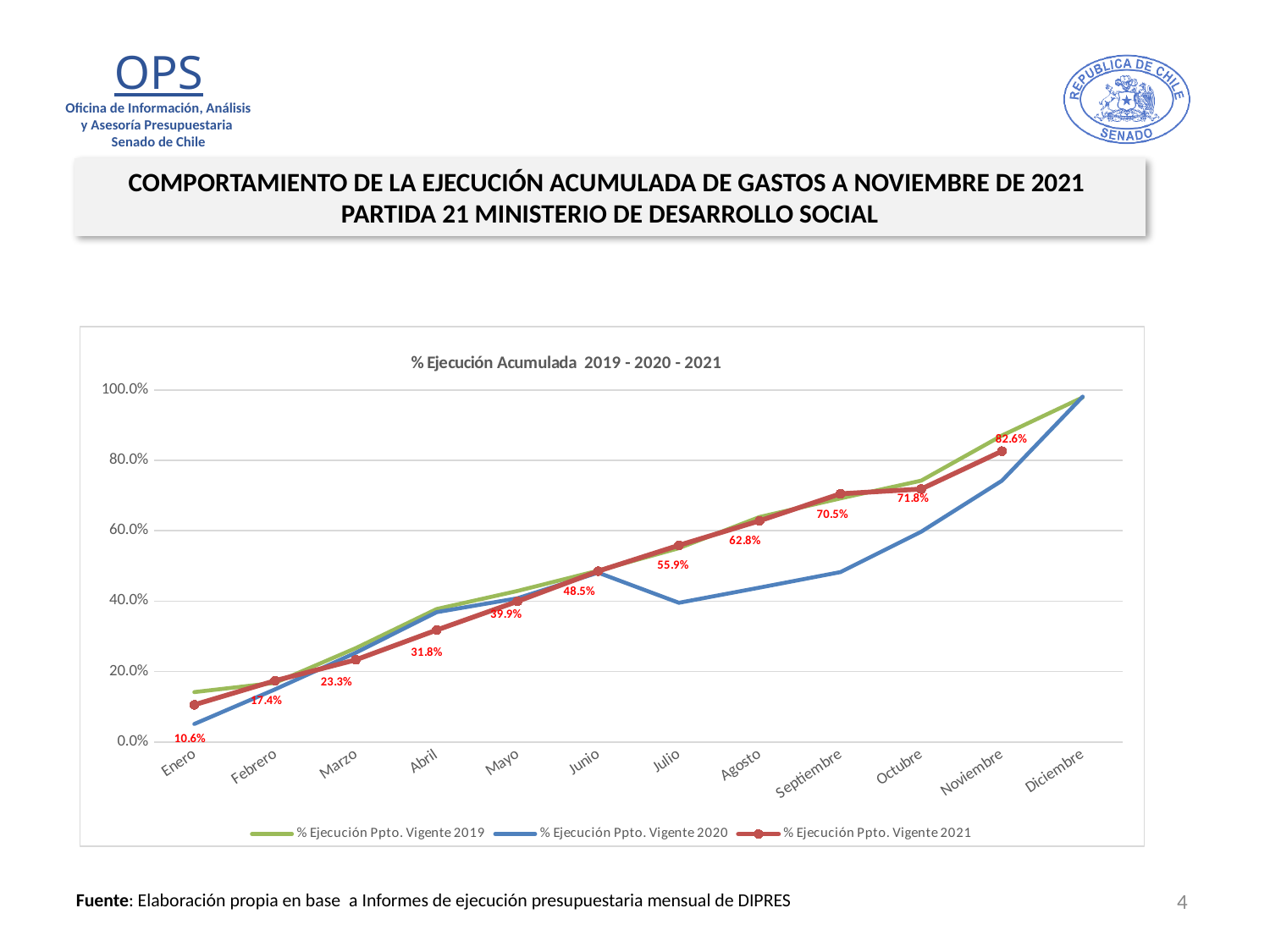
By how many percentage points did % Ejecución Ppto. Vigente 2021 increase from Octubre to Noviembre? 10.8% What is the title of the chart? % Ejecución Acumulada 2019 - 2020 - 2021 Is the value for % Ejecución Ppto. Vigente 2020 in Enero greater or less than 20.0%? less Does the % Ejecución Ppto. Vigente 2021 series rise or fall from Enero to Noviembre? Rise What is the difference between the 2021 values for Junio and Mayo? 8.6% What kind of chart is shown on the slide? Line chart What is the value of % Ejecución Ppto. Vigente 2021 for Noviembre? 82.6% In Julio, which series has the higher value: % Ejecución Ppto. Vigente 2020 or % Ejecución Ppto. Vigente 2021? % Ejecución Ppto. Vigente 2021 How many months are shown on the x axis? 12 How many series does the legend list? 3 What is the value of % Ejecución Ppto. Vigente 2021 for Septiembre? 70.5% What is the value of % Ejecución Ppto. Vigente 2021 for Enero? 10.6%